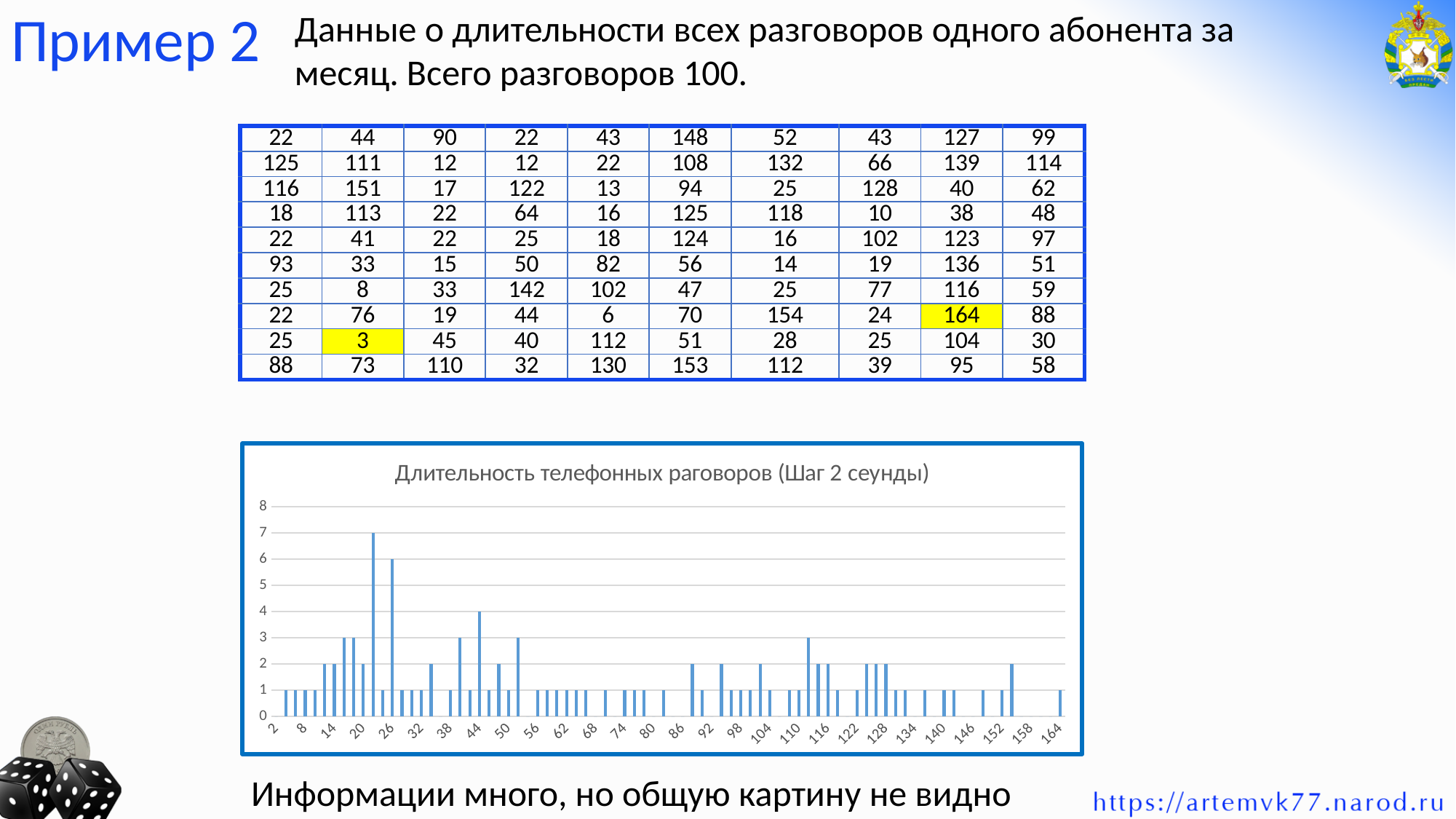
What is the difference between the tallest bar and the bar at 44? 3 How many tick labels are shown on the horizontal axis of the chart? 28 What is the highest tick value shown on the vertical axis of the chart? 8 What is the value of the bar at 44 on the horizontal axis? 4 What kind of chart is shown on the slide? bar chart Is the value of the tallest bar greater or less than 5? greater Is the value of the bar at 164 greater or less than 3? less What is the value of the tallest bar in the chart? 7 What is the value of the bar at 8 on the horizontal axis? 1 Which bar is taller: the one at 44 or the one at 164 on the horizontal axis? 44 What is the title of the chart on the slide? Длительность телефонных рагoворов (Шаг 2 сеунды) What is the value of the bar at 164 on the horizontal axis? 1